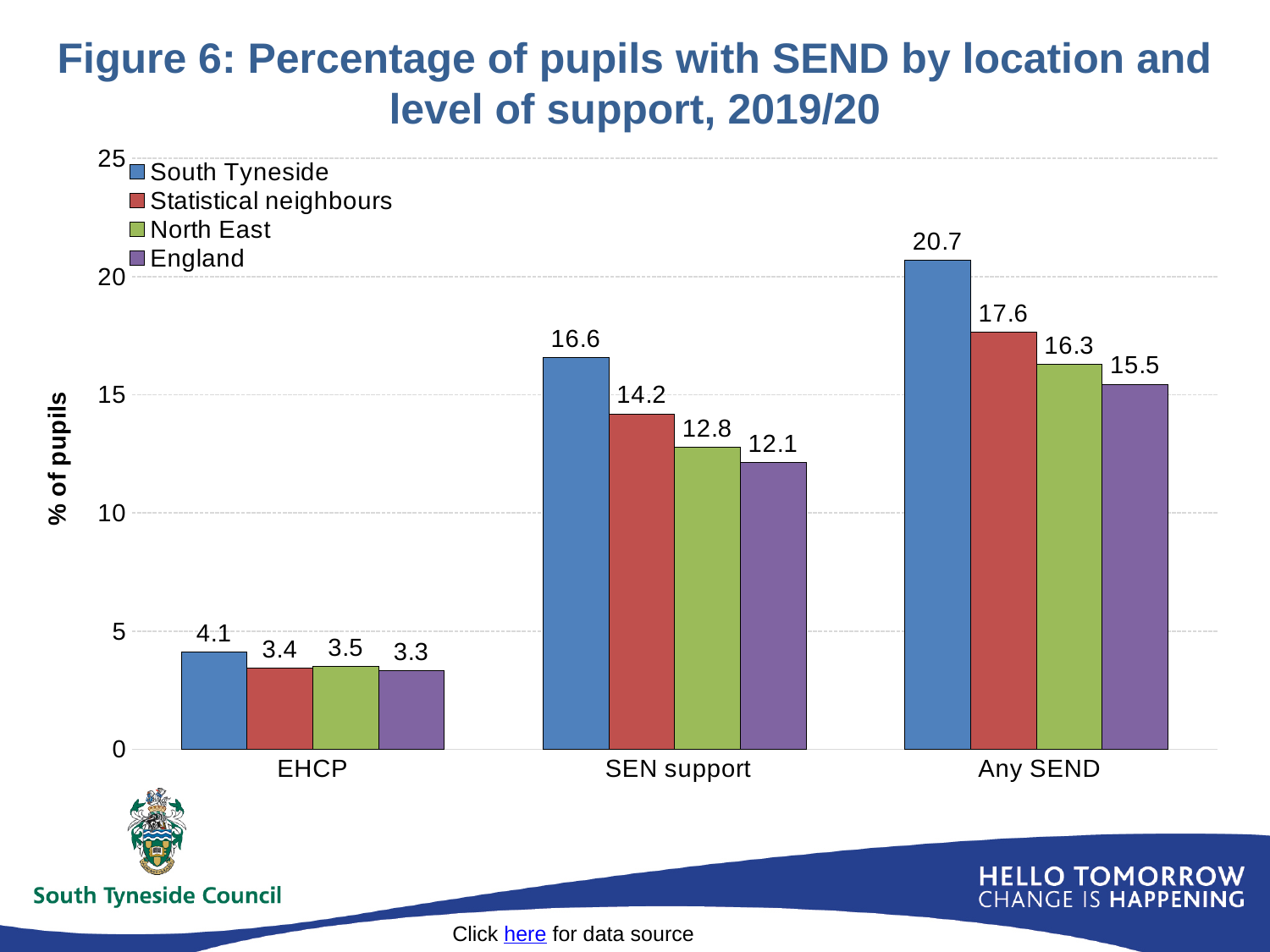
Which location has the lowest value in the Any SEND category? England What is the difference between South Tyneside and England in the SEN support category? 4.5 Is the value for South Tyneside in the Any SEND category greater or less than 20? greater What is the difference between South Tyneside and Statistical neighbours in the Any SEND category? 3.1 What is the value for North East in the EHCP category? 3.5 What kind of chart is shown on the slide? Bar chart How many series does the legend list? 4 How many categories are shown on the x axis? 3 What is the value for South Tyneside in the Any SEND category? 20.7 Which location has the highest value in the SEN support category? South Tyneside What is the value for England in the SEN support category? 12.1 Which is larger in the EHCP category: Statistical neighbours or North East? North East